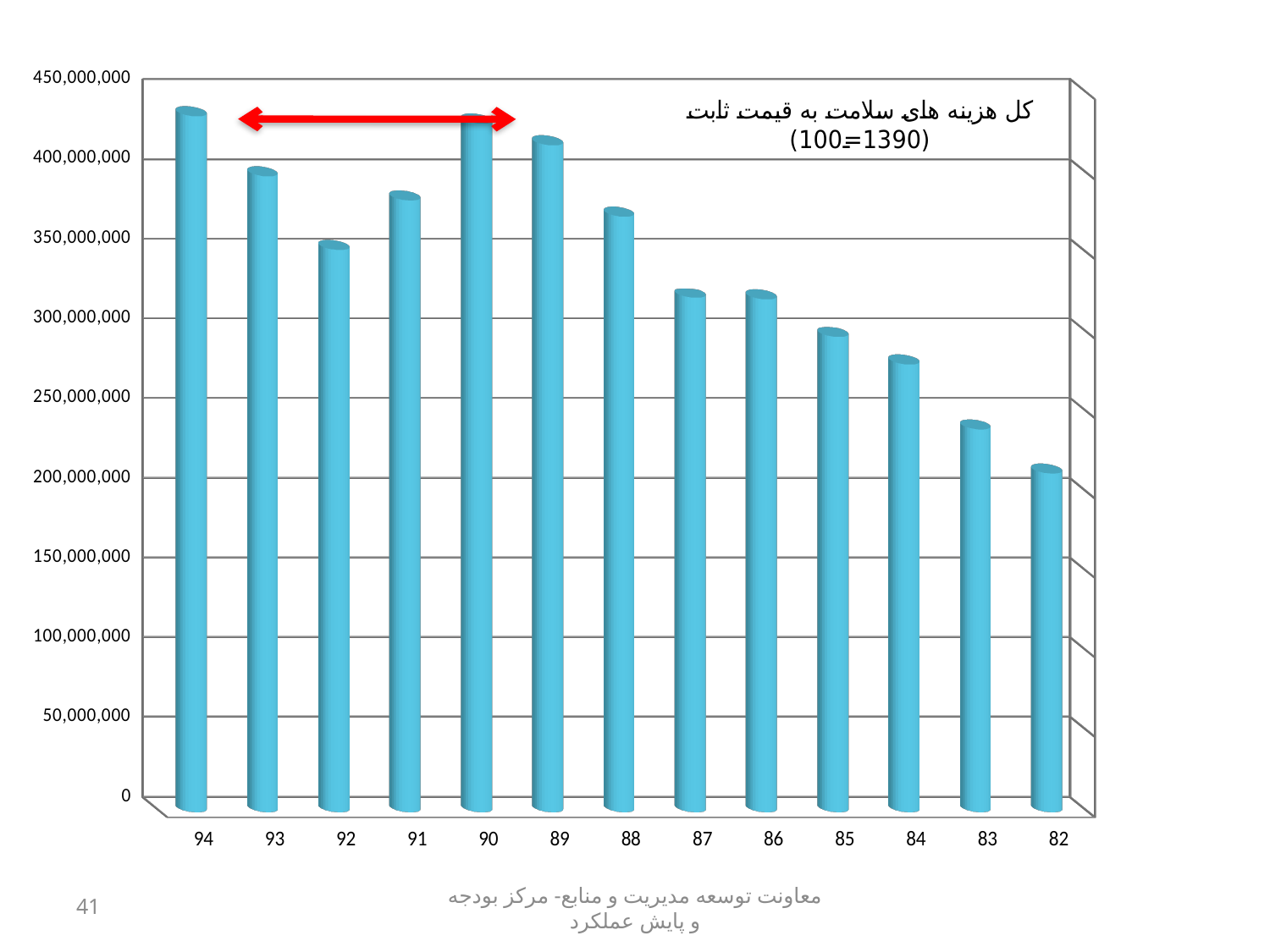
Is the value for year 87 greater or less than 300,000,000? greater Is the value for year 83 greater or less than 250,000,000? less Which is larger, the value for year 89 or the value for year 88? 89 How many bars (years) are plotted on the chart? 13 Which year has the lowest value on the chart? 82 What kind of chart is shown on the slide? bar chart Which is larger, the value for year 93 or the value for year 92? 93 Moving from year 82 to year 94, do the values generally rise or fall? rise Is the value for year 91 greater or less than 350,000,000? greater What colour are the bars on the chart? blue